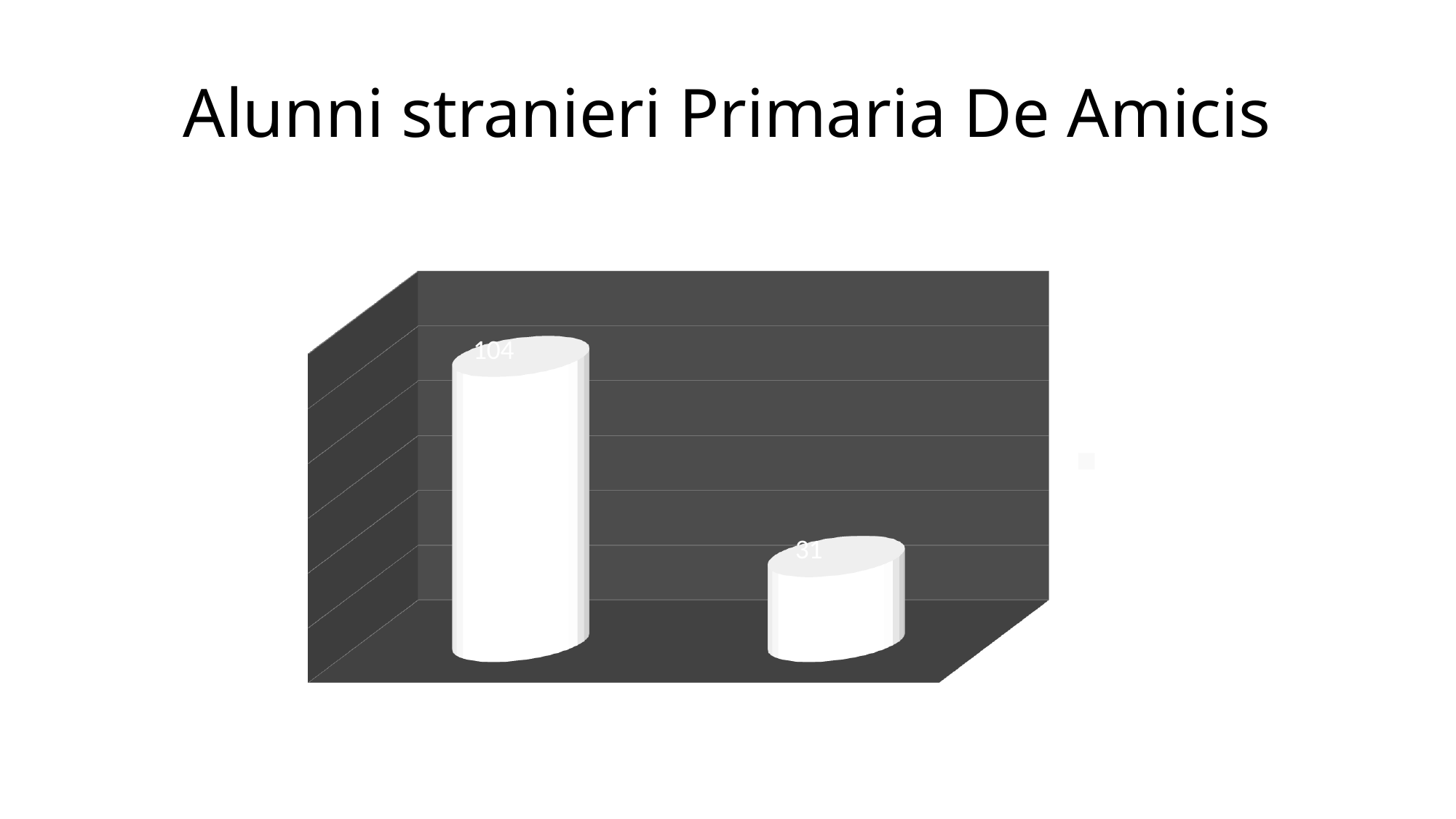
What is the value shown on the left bar of the chart? 104 What is the value shown on the right bar of the chart? 31 Do the values fall or rise from the left bar to the right bar? fall What is the lowest value shown in the chart? 31 What is the title of the chart on the slide? Alunni stranieri Primaria De Amicis Which bar has the larger value, the left one or the right one? the left one What kind of chart is shown on the slide? bar chart What colour are the bars in the chart? white What is the highest value shown in the chart? 104 What is the difference between the left bar's value and the right bar's value? 73 How many bars are plotted in the chart? 2